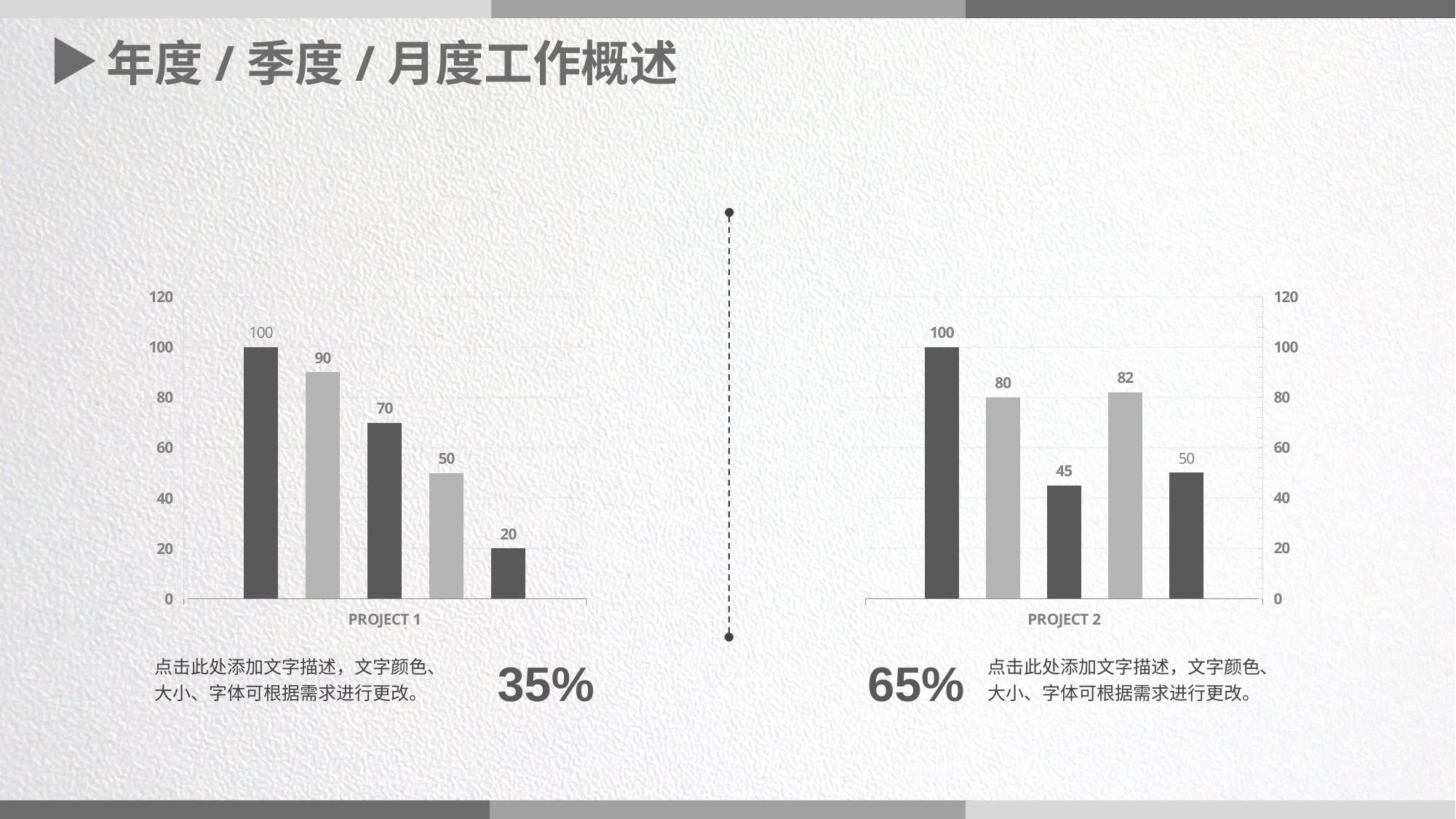
In the PROJECT 2 chart on the right, what is the value of the fourth bar from the left? 82 In the PROJECT 2 chart on the right, what is the difference between the first bar (100) and the third bar (45)? 55 In the PROJECT 2 chart on the right, which is larger: the second bar (80) or the fourth bar (82)? the fourth bar (82) In the PROJECT 2 chart on the right, what is the value of the shortest bar? 45 How many bars are plotted in the PROJECT 1 chart on the left? 5 In the PROJECT 1 chart on the left, what is the difference between the first bar (100) and the last bar (20)? 80 What is the category label shown under the x axis of the chart on the left? PROJECT 1 In the PROJECT 1 chart on the left, what is the value of the third bar from the left? 70 In the PROJECT 1 chart on the left, what is the value of the shortest bar? 20 In the PROJECT 1 chart on the left, do the bar values rise or fall from left to right? fall In the PROJECT 1 chart on the left, what is the value of the tallest bar? 100 What type of chart is the PROJECT 2 chart on the right? bar chart